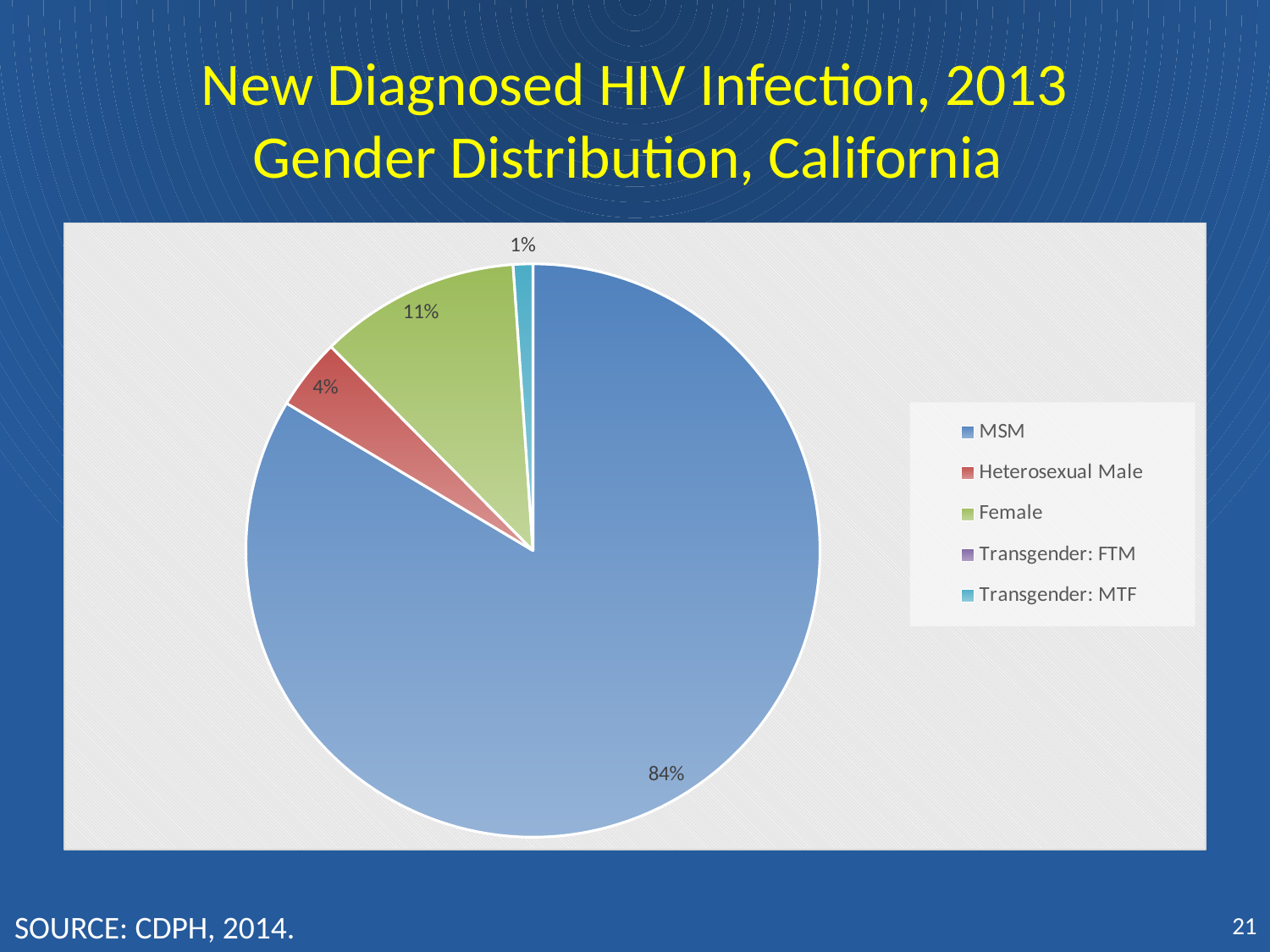
What share of new diagnosed HIV infections is attributed to Female? 11% What share of new diagnosed HIV infections is attributed to Transgender: MTF? 1% What colour is the Female slice of the pie? green What is the title of the slide containing the chart? New Diagnosed HIV Infection, 2013 Gender Distribution, California How many entries does the legend list? 5 What share of new diagnosed HIV infections is attributed to MSM? 84% Which category has the largest share of the pie? MSM What is the difference in percentage points between the MSM share and the Female share? 73 Which is larger, the Female share or the Heterosexual Male share? Female What kind of chart is shown on the slide? pie chart Which of the labelled slices has the smallest share of the pie? Transgender: MTF What share of new diagnosed HIV infections is attributed to Heterosexual Male? 4%